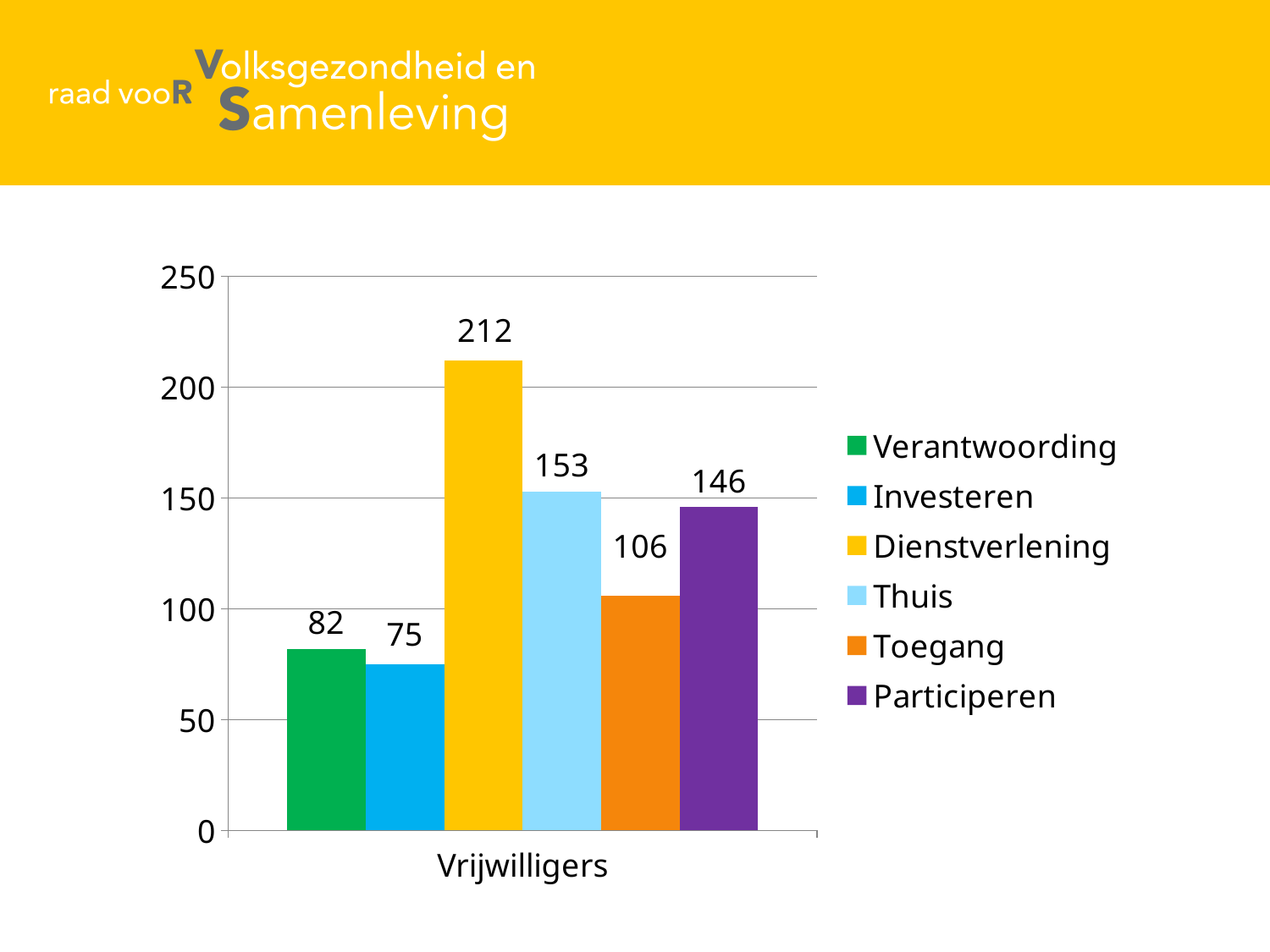
What kind of chart is shown on the slide? bar chart Which series has the lowest value? Investeren Is the value for Toegang greater or less than 100? greater What is the value for Investeren? 75 What is the difference between the values for Dienstverlening and Thuis? 59 Which is larger, the value for Thuis or the value for Participeren? Thuis What is the difference between the values for Toegang and Verantwoording? 24 What is the value for Participeren? 146 What is the value for Dienstverlening in the Vrijwilligers chart? 212 Which series has the highest value? Dienstverlening What is the category label on the x axis? Vrijwilligers How many series does the legend list? 6